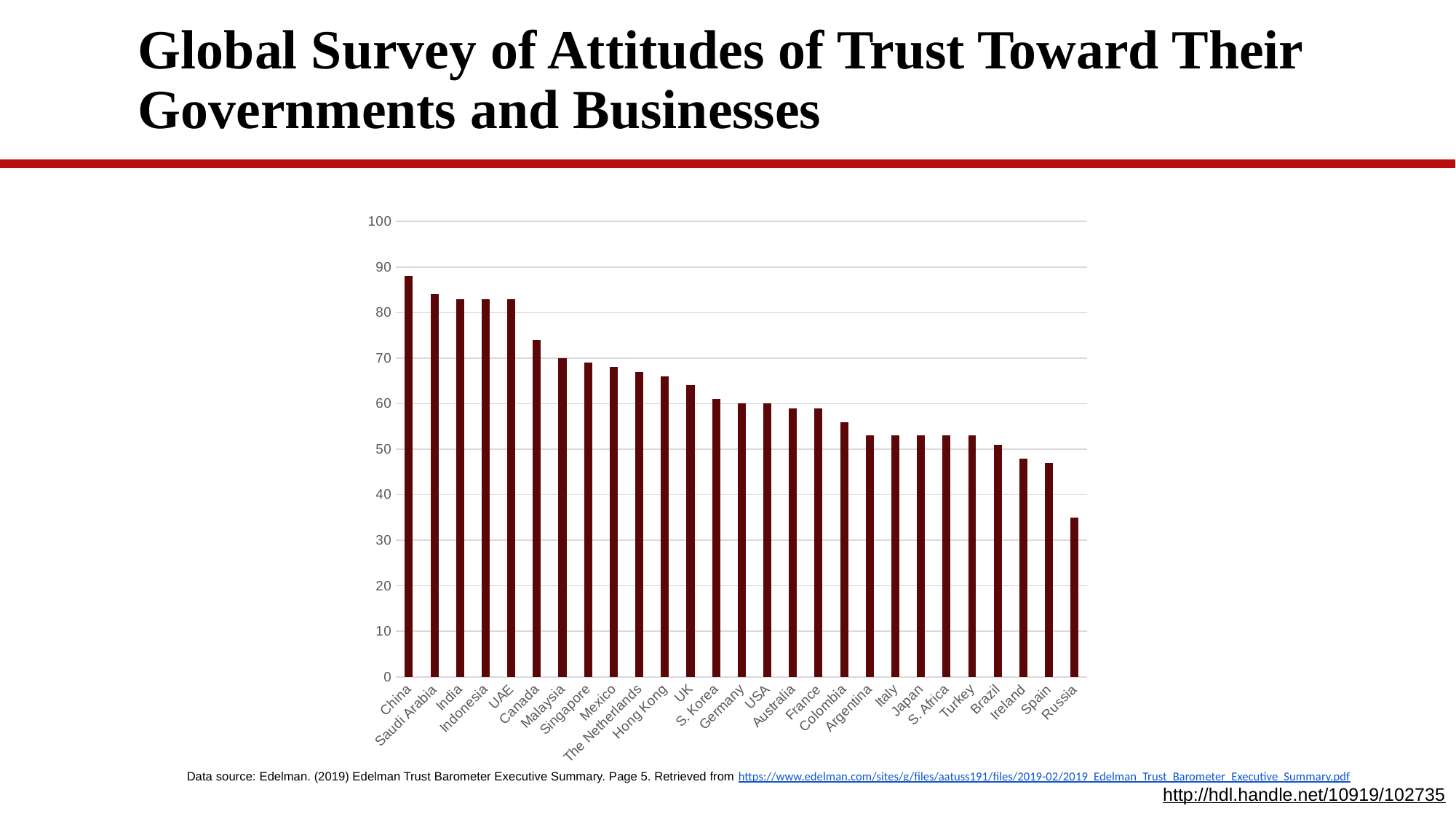
Which has a larger value, Canada or Japan? Canada How many countries are shown on the x axis of the chart? 27 Which country has the lowest bar in the chart? Russia Is the value for Canada greater or less than 70? greater Is the value for Hong Kong greater or less than 60? greater What kind of chart is shown on the slide? bar chart Which country has the highest bar in the chart? China Is the value for Spain greater or less than 50? less Do the values generally rise or fall moving from left to right along the x axis? fall What is the title of the slide containing the chart? Global Survey of Attitudes of Trust Toward Their Governments and Businesses